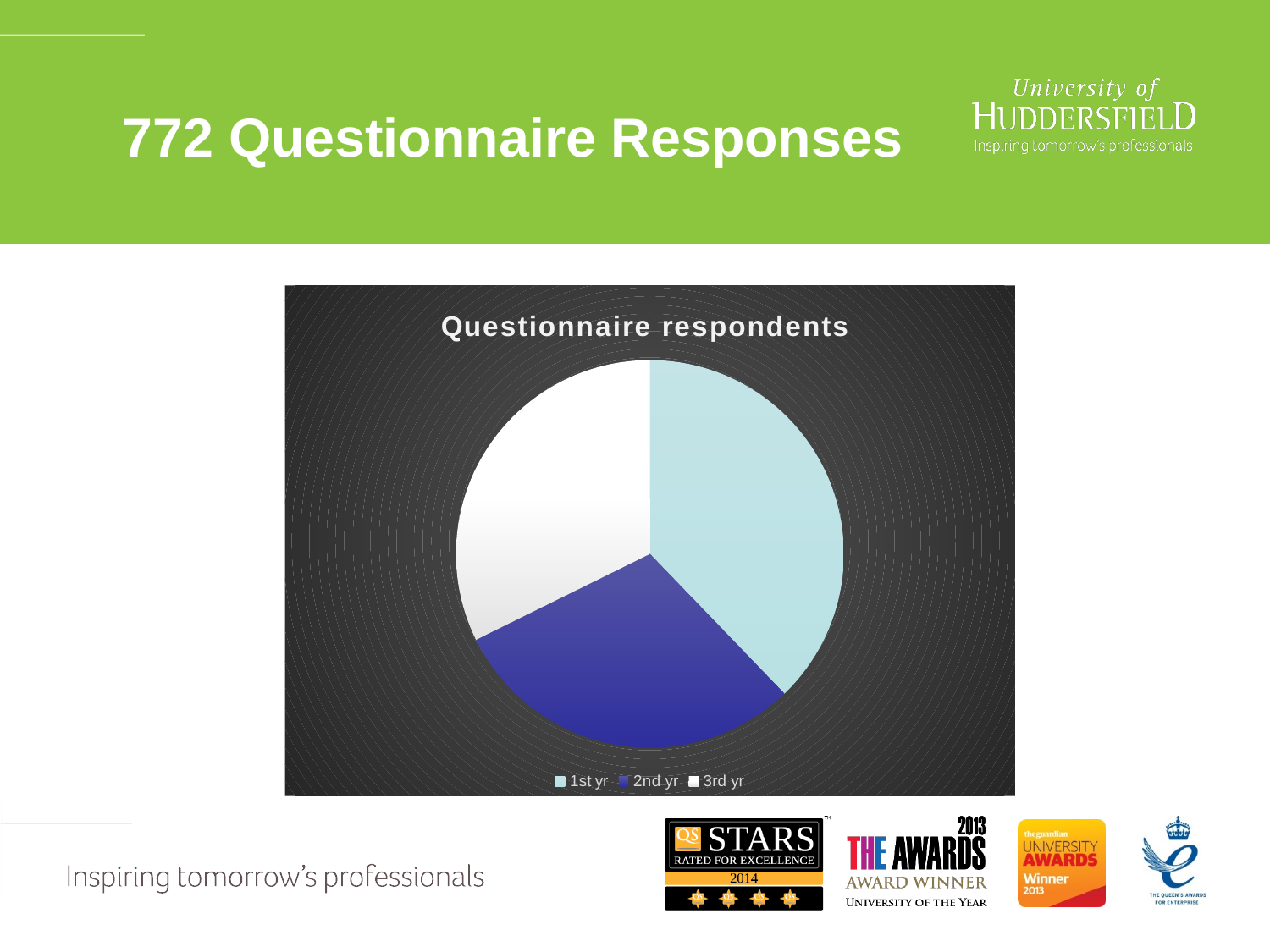
Which slice is larger, 1st yr or 2nd yr? 1st yr What kind of chart is shown on the slide? pie chart Which category has the largest slice of the pie? 1st yr Which category is shown in white in the pie chart? 3rd yr Which slice is larger, 1st yr or 3rd yr? 1st yr How many entries does the chart legend list? 3 How many slices does the pie chart have? 3 What is the title of the chart? Questionnaire respondents